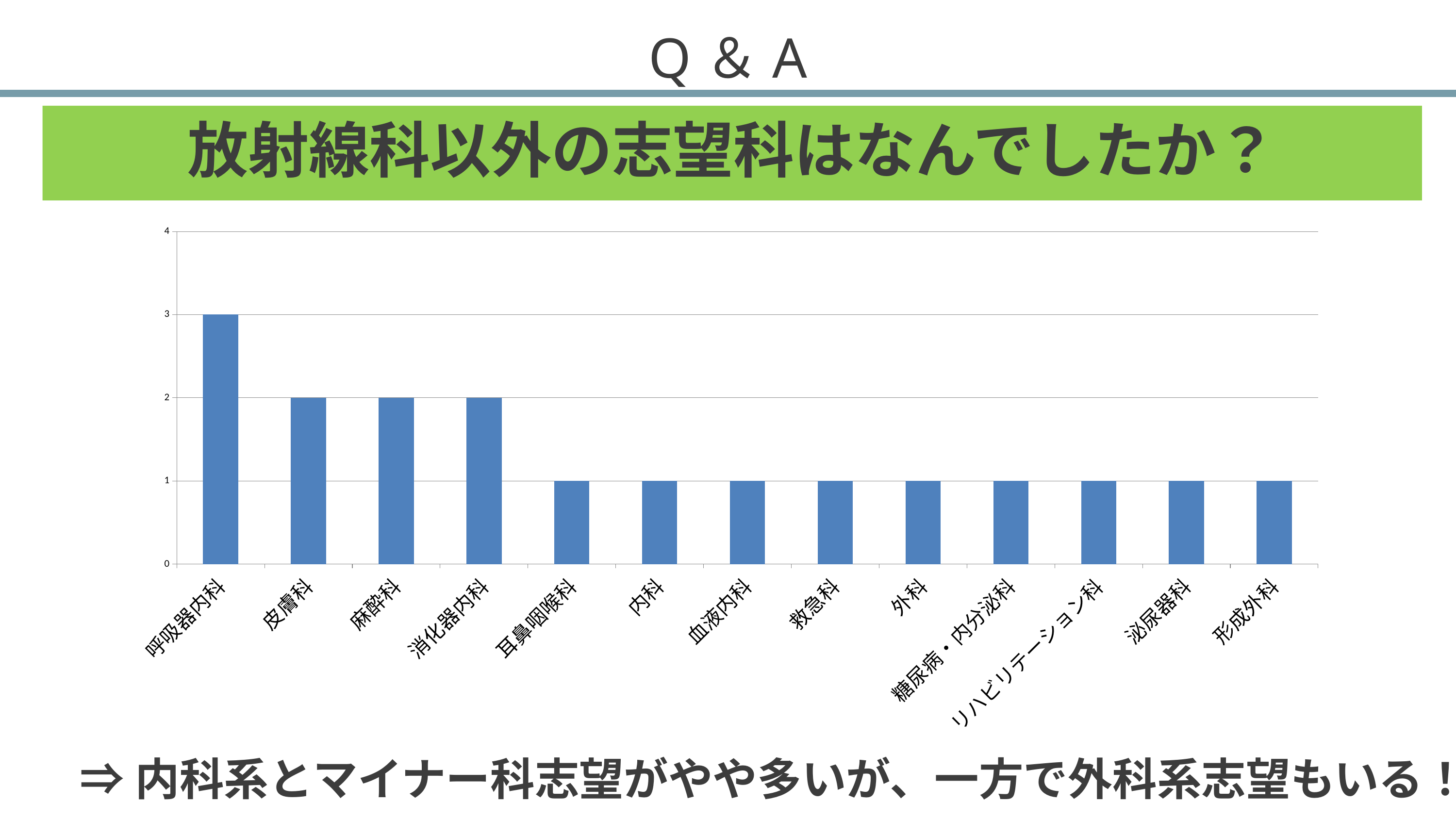
What is the difference between the values for 呼吸器内科 and 皮膚科? 1 What is the value for 皮膚科? 2 What is the value for 消化器内科? 2 Do the values generally rise or fall from left to right along the x axis? fall What is the value for 麻酔科? 2 What kind of chart is shown on the slide? bar chart What is the value for 外科? 1 Which department has the highest bar in the chart? 呼吸器内科 How many categories (departments) are shown on the x axis of the chart? 13 What is the value for 形成外科? 1 What is the value for 呼吸器内科? 3 Which is larger, the value for 麻酔科 or the value for 救急科? 麻酔科